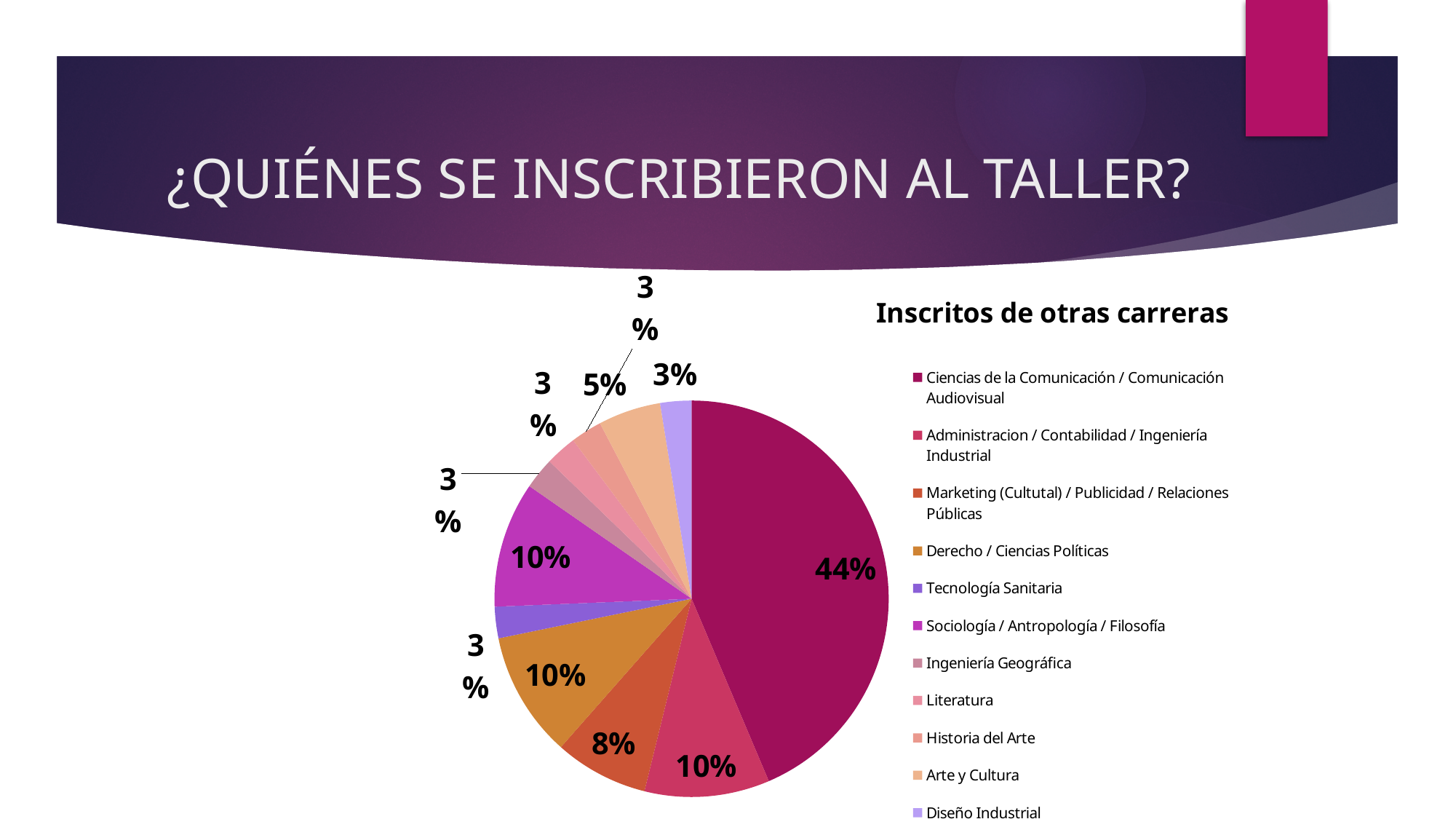
What share of the pie does Derecho / Ciencias Políticas have? 10% What is the difference in percentage points between the Ciencias de la Comunicación / Comunicación Audiovisual slice and the Administracion / Contabilidad / Ingeniería Industrial slice? 34 What is the title of the chart? Inscritos de otras carreras How many categories does the legend of the pie chart list? 11 What share of the pie does Sociología / Antropología / Filosofía have? 10% Which legend entry is listed last in the pie chart's legend? Diseño Industrial What share of the pie does Marketing (Cultutal) / Publicidad / Relaciones Públicas have? 8% Which category has the largest slice of the pie? Ciencias de la Comunicación / Comunicación Audiovisual What type of chart is shown on the slide? pie chart Which is larger, the slice for Derecho / Ciencias Políticas or the slice for Marketing (Cultutal) / Publicidad / Relaciones Públicas? Derecho / Ciencias Políticas